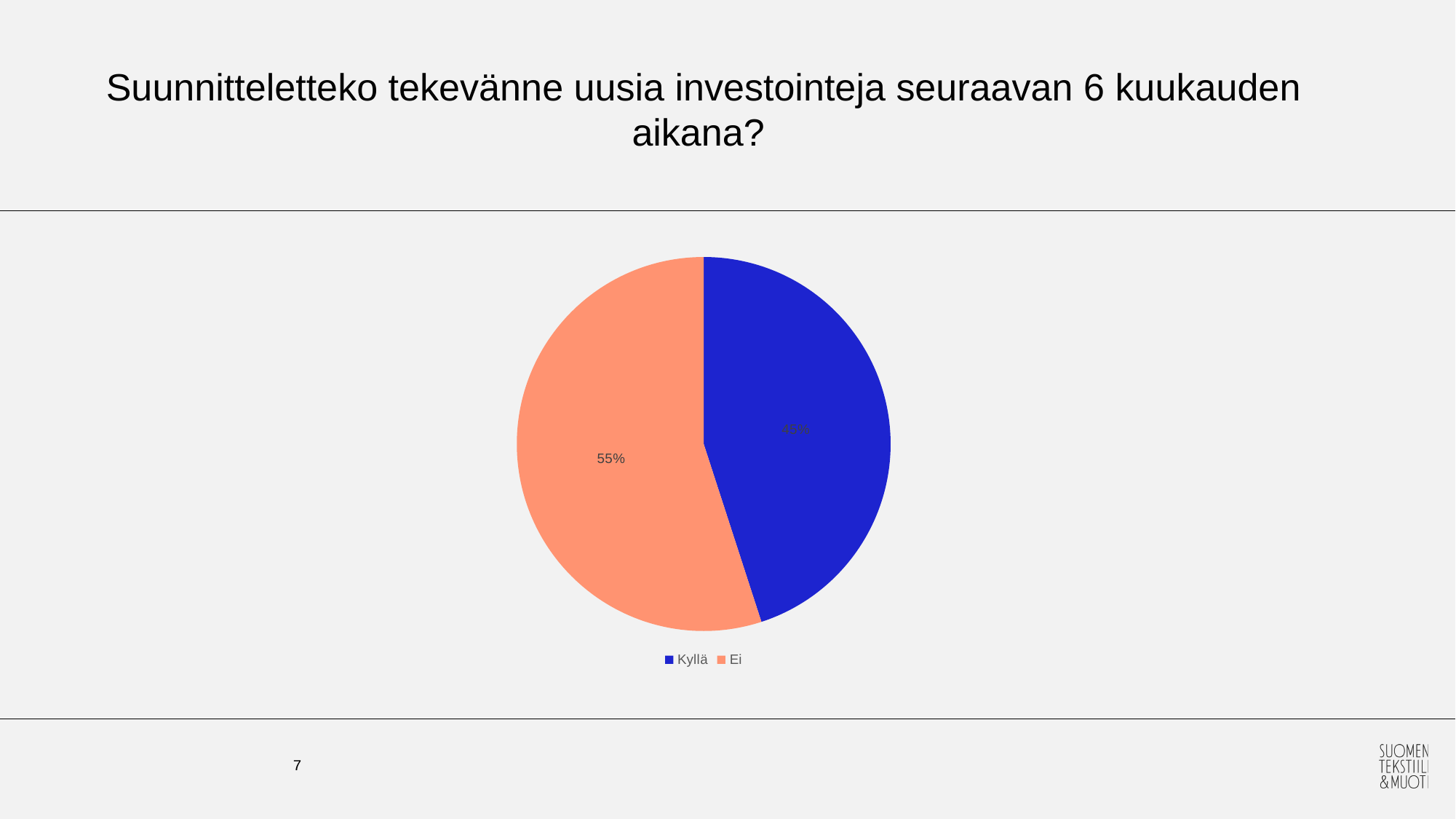
Which slice is the smallest? Kyllä Which slice is the largest? Ei What kind of chart is shown on the slide? pie chart What colour is the "Kyllä" slice? blue What share of the pie does "Kyllä" represent? 45% How many slices does the pie chart have? 2 How many entries does the legend list? 2 What is the title of the slide above the chart? Suunnitteletteko tekevänne uusia investointeja seuraavan 6 kuukauden aikana? What is the difference between the share for "Ei" and the share for "Kyllä"? 10% Which is larger, the share for "Kyllä" or the share for "Ei"? Ei What share of the pie does "Ei" represent? 55%